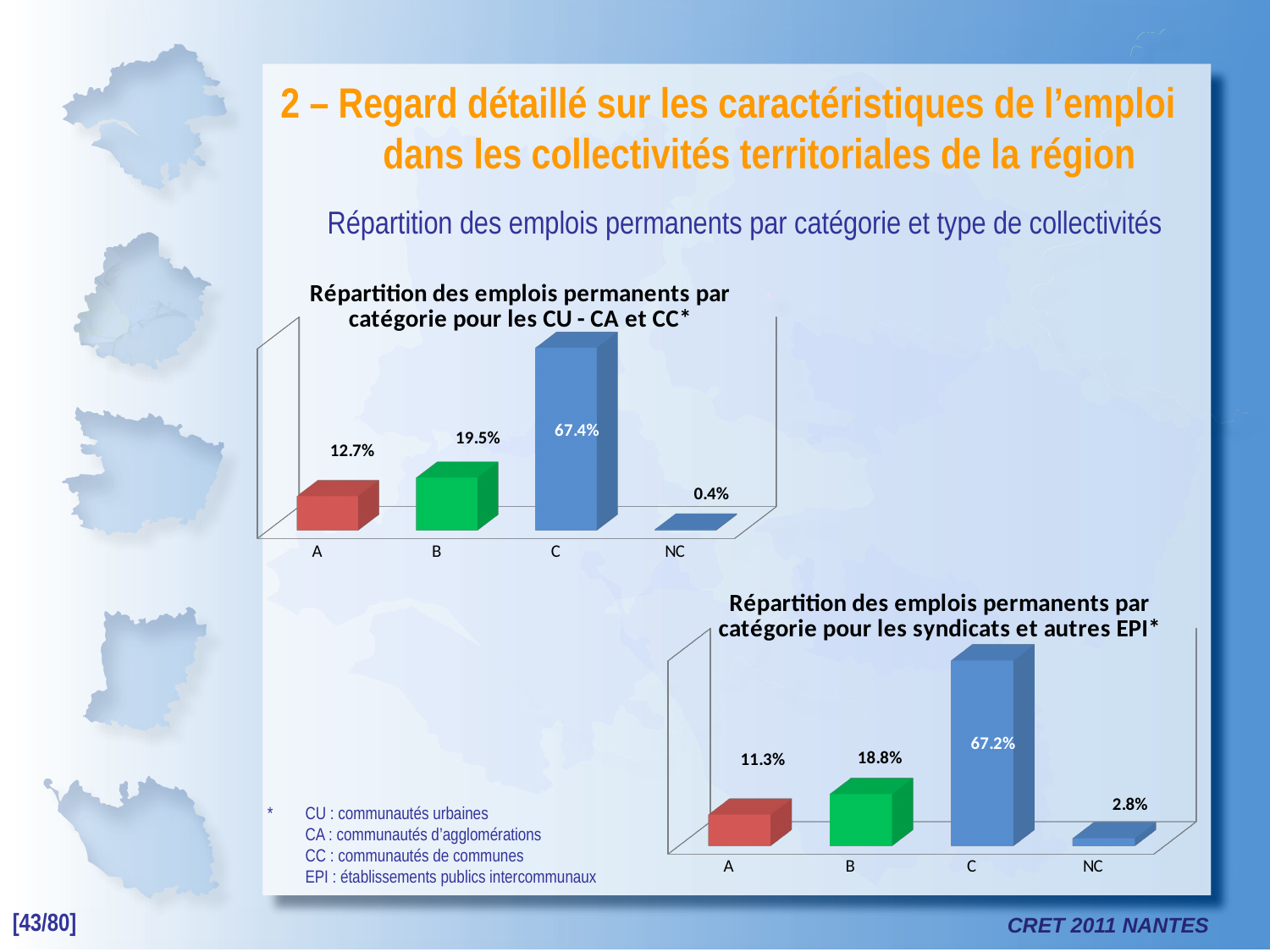
In the chart 'Répartition des emplois permanents par catégorie pour les CU - CA et CC*', what is the difference between the values for B and A? 6.8% In the chart 'Répartition des emplois permanents par catégorie pour les CU - CA et CC*', what colour is the bar for category B? Green What kind of chart is 'Répartition des emplois permanents par catégorie pour les syndicats et autres EPI*'? Bar chart How many categories are shown in the chart 'Répartition des emplois permanents par catégorie pour les CU - CA et CC*'? 4 In the chart 'Répartition des emplois permanents par catégorie pour les CU - CA et CC*', what is the value for category C? 67.4% In the chart 'Répartition des emplois permanents par catégorie pour les CU - CA et CC*', which category has the highest value? C In the chart 'Répartition des emplois permanents par catégorie pour les syndicats et autres EPI*', what is the value for category B? 18.8% In the chart 'Répartition des emplois permanents par catégorie pour les syndicats et autres EPI*', what is the value for NC? 2.8% In the chart 'Répartition des emplois permanents par catégorie pour les syndicats et autres EPI*', what is the difference between the values for C and B? 48.4% In the chart 'Répartition des emplois permanents par catégorie pour les CU - CA et CC*', what is the value for category A? 12.7% Which is larger: the value for NC in the CU - CA et CC chart or the value for NC in the syndicats et autres EPI chart? syndicats et autres EPI In the chart 'Répartition des emplois permanents par catégorie pour les syndicats et autres EPI*', which category has the lowest value? NC